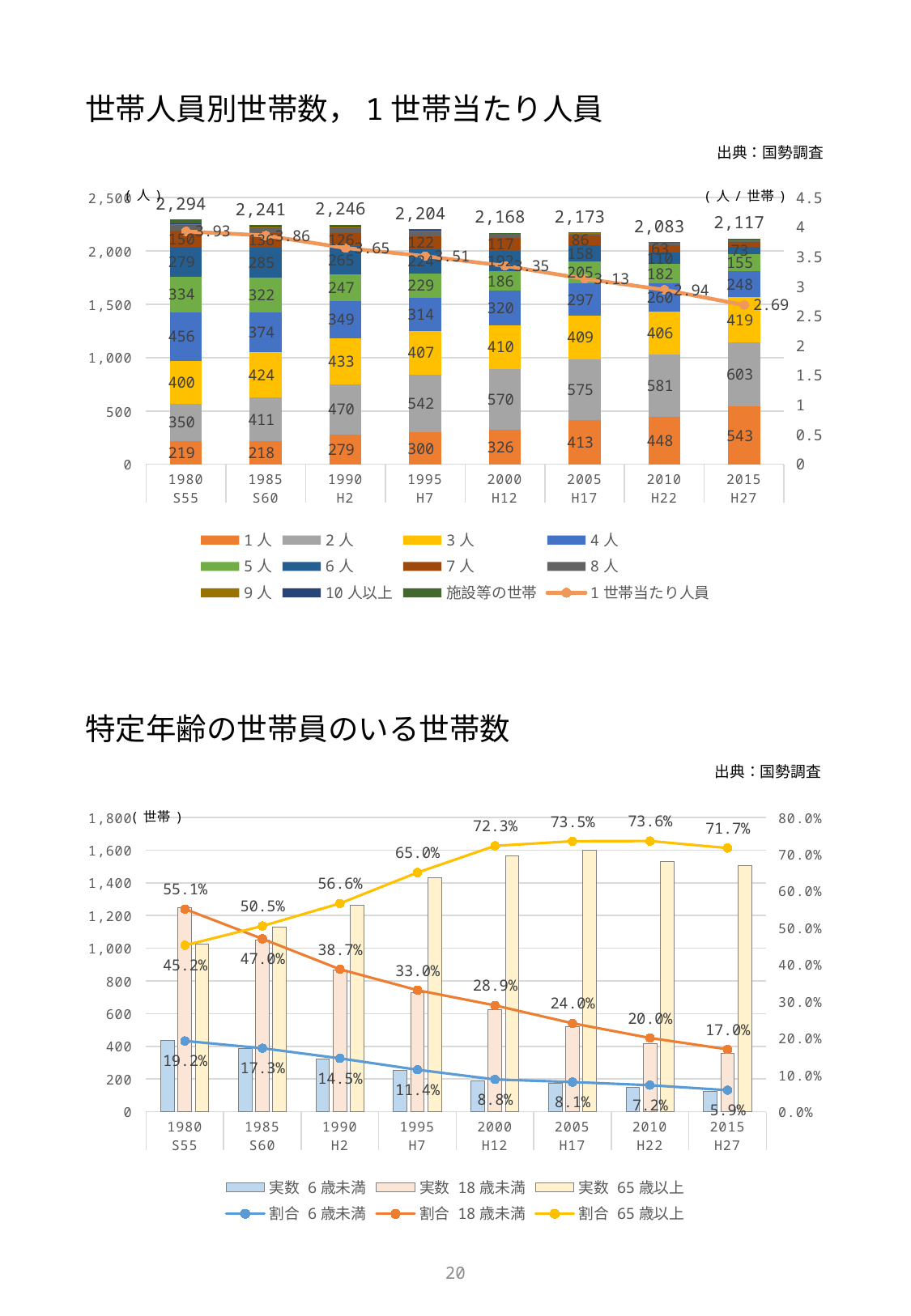
In the top chart (世帯人員別世帯数，１世帯当たり人員), which year has the lowest total number of households? 2010 (H22) In the top chart (世帯人員別世帯数，１世帯当たり人員), which year has the highest total number of households? 1980 (S55) In the top chart (世帯人員別世帯数，１世帯当たり人員), how many years are shown on the x axis? 8 In the top chart (世帯人員別世帯数，１世帯当たり人員), what is the difference between the 2人 segment in 2015 (H27) and the 2人 segment in 1980 (S55)? 253 In the top chart (世帯人員別世帯数，１世帯当たり人員), what is the value of the 1人 segment for 2015 (H27)? 543 In the bottom chart (特定年齢の世帯員のいる世帯数), how many series does the legend list? 6 In the bottom chart (特定年齢の世帯員のいる世帯数), what is the 割合 65歳以上 value for 2010 (H22)? 73.6% In the bottom chart (特定年齢の世帯員のいる世帯数), which is larger in 1980 (S55): 割合 18歳未満 or 割合 65歳以上? 割合 18歳未満 In the top chart (世帯人員別世帯数，１世帯当たり人員), what is the 1世帯当たり人員 value for 2015 (H27)? 2.69 In the top chart (世帯人員別世帯数，１世帯当たり人員), does the 1世帯当たり人員 line rise or fall from 1980 to 2015? fall In the top chart (世帯人員別世帯数，１世帯当たり人員), what is the total number of households shown above the bar for 1980 (S55)? 2,294 In the bottom chart (特定年齢の世帯員のいる世帯数), which year has the lowest 割合 6歳未満 value? 2015 (H27)